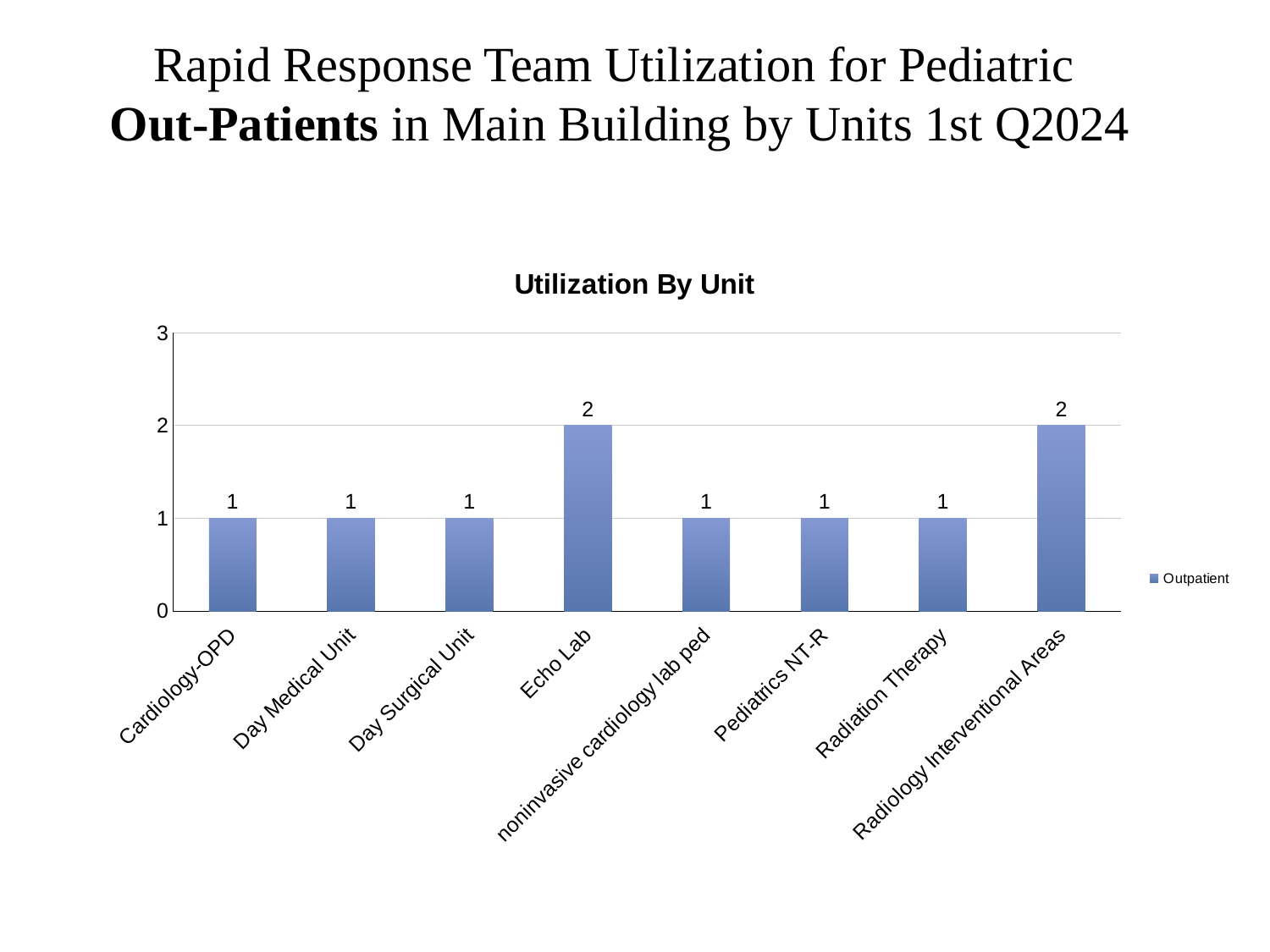
How many units are shown on the x axis? 8 Which units have the highest value? Echo Lab and Radiology Interventional Areas Which is larger, the value for Radiology Interventional Areas or the value for Radiation Therapy? Radiology Interventional Areas What is the value for Radiology Interventional Areas? 2 What is the value for Day Medical Unit? 1 What is the value for Pediatrics NT-R? 1 What is the title of the chart? Utilization By Unit What is the value for Echo Lab? 2 What kind of chart is shown? Bar chart What series name is shown in the legend? Outpatient What is the difference between the values for Echo Lab and Cardiology-OPD? 1 How many series does the legend list? 1